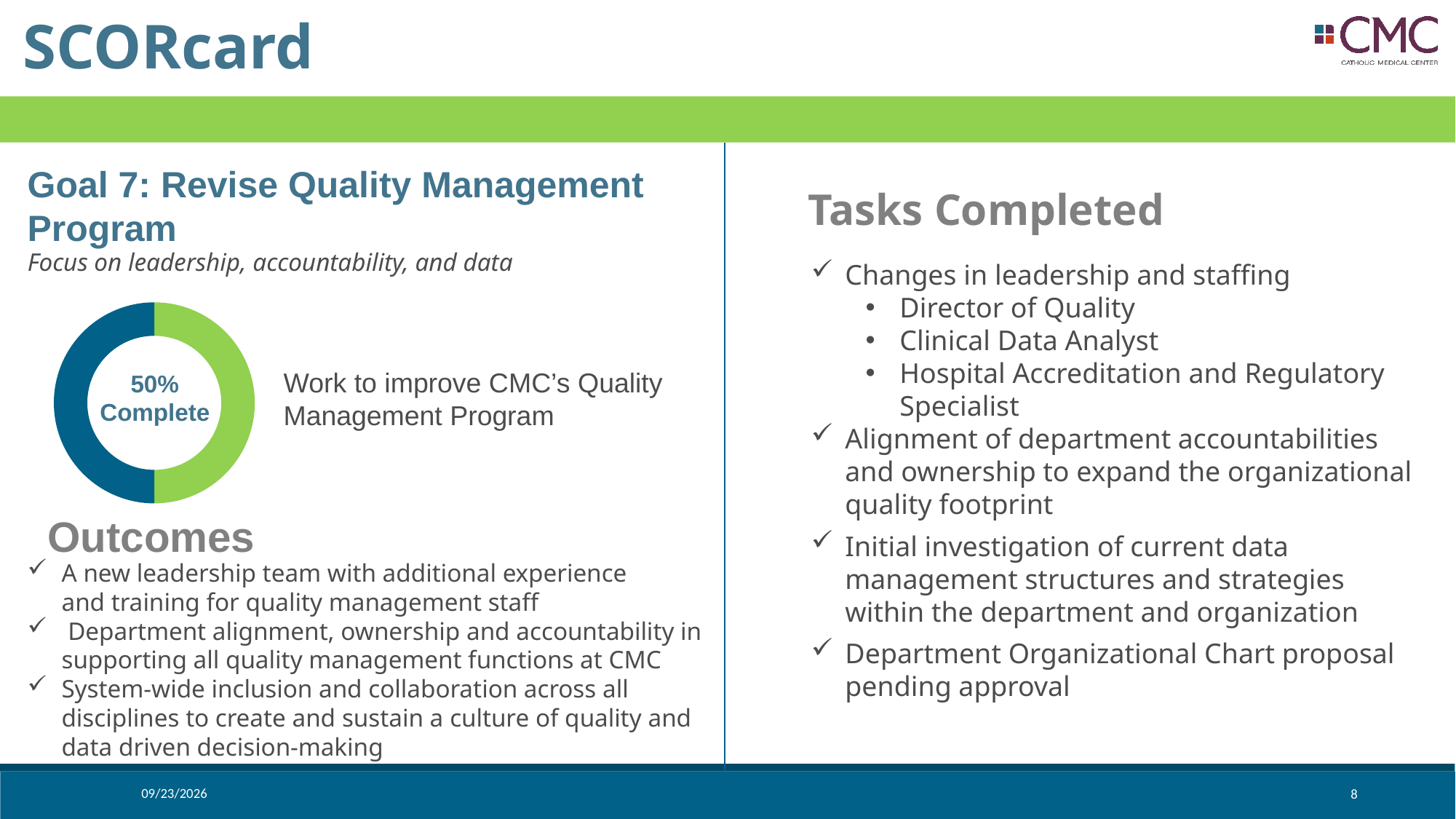
What percentage complete does the donut chart show? 50% Complete What kind of chart is shown on the slide? Donut chart What two colours are used for the segments of the donut chart? Dark blue and green How many segments does the donut chart have? 2 What text is printed in the centre of the donut chart? 50% Complete Are the two segments of the donut chart equal in size? Yes What share of the donut chart does the completed portion represent? 50%